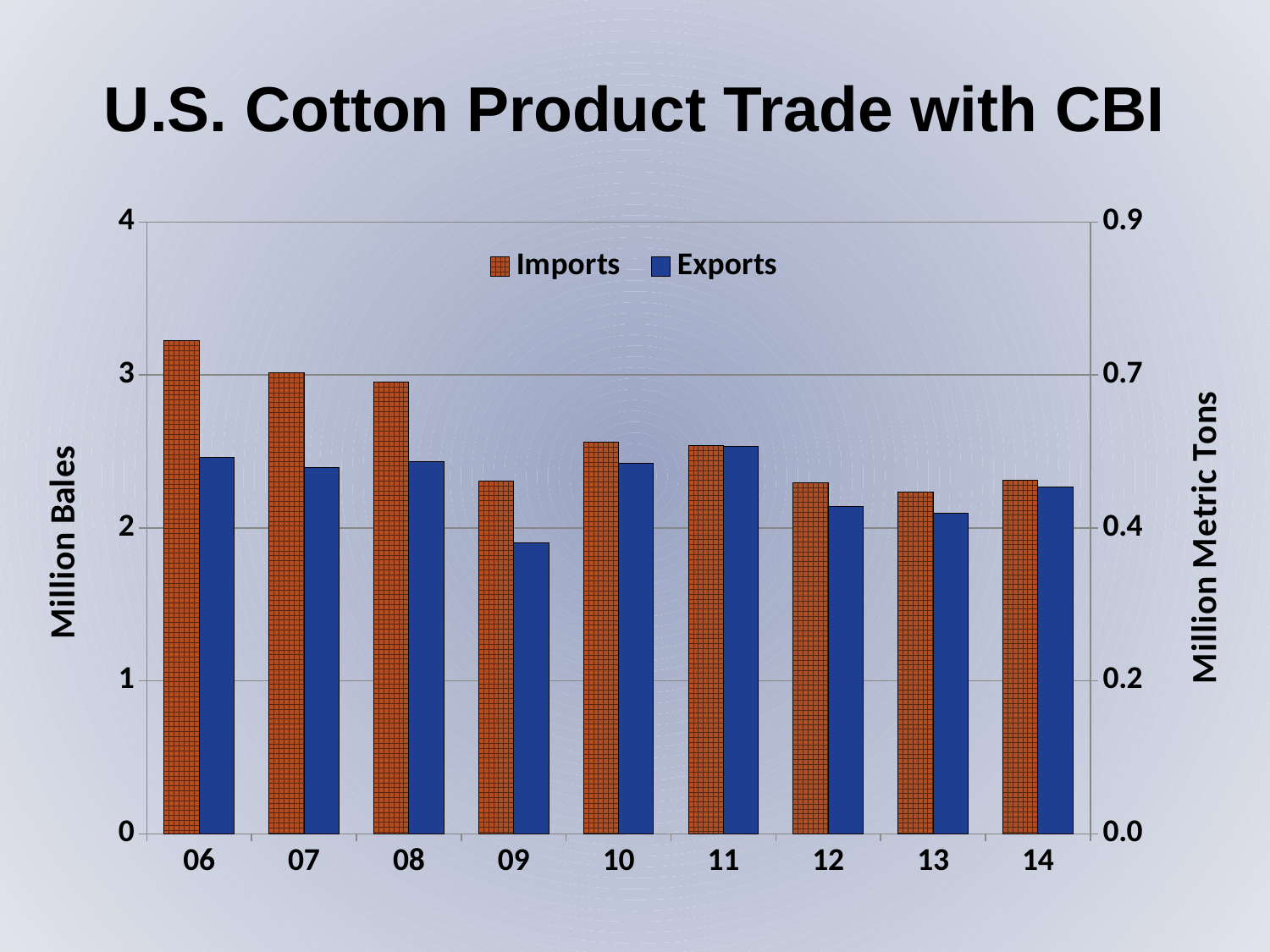
Do Imports generally rise or fall from 06 to 14? Fall How many series does the legend list? 2 Which year has the highest Imports value? 06 In 06, which is larger, Imports or Exports? Imports Is the Exports value for 09 greater or less than 2 million bales? less How many years are shown on the x axis? 9 What is the label on the left vertical axis? Million Bales Which year has the lowest Exports value? 09 Is the Imports value for 09 greater or less than 2 million bales? greater Which is larger, Imports in 06 or Imports in 09? Imports in 06 Is the Imports value for 06 greater or less than 3 million bales? greater What kind of chart is shown on the slide? Bar chart